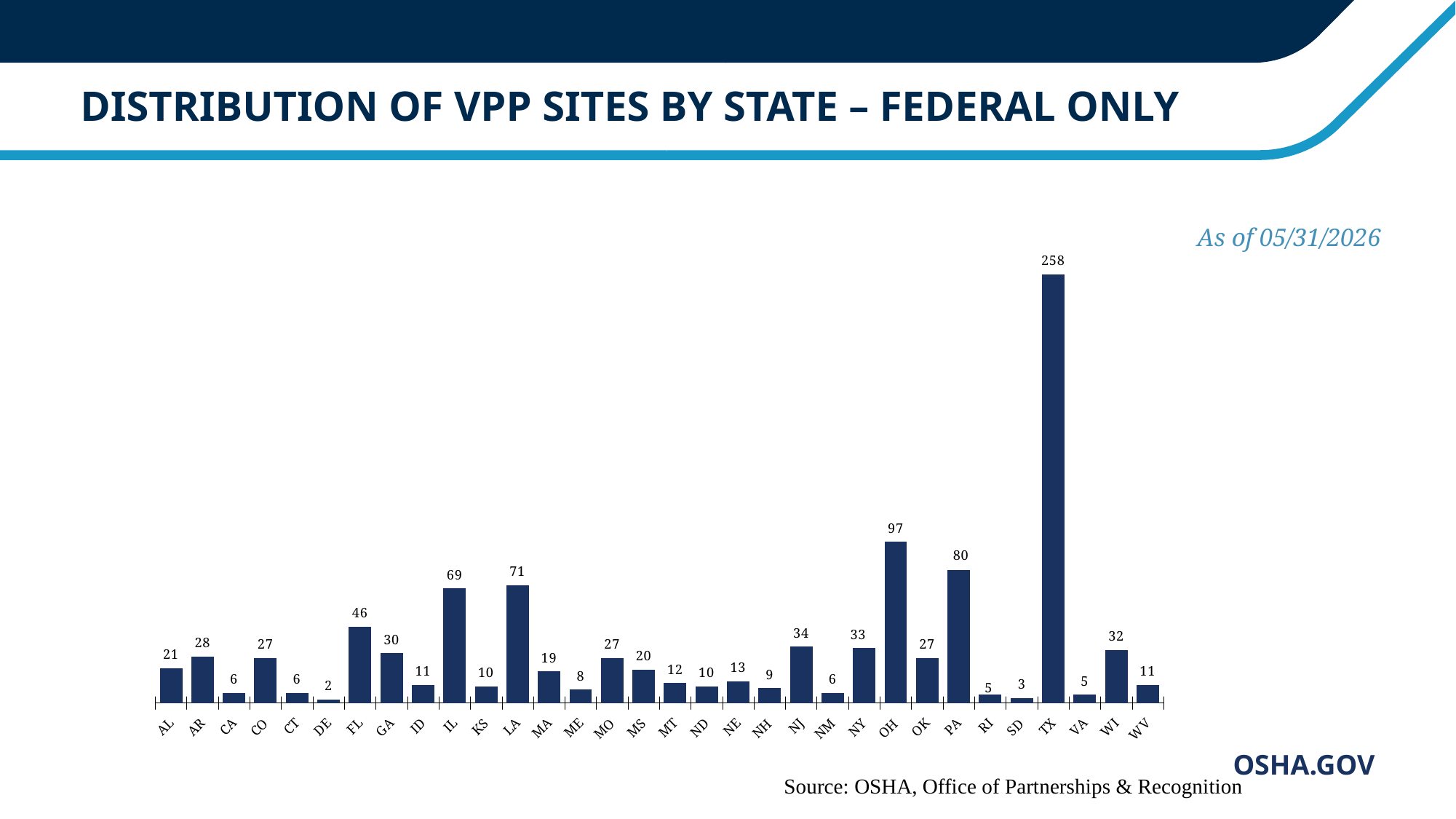
What is the value for FL? 46 What is the value for TX? 258 How many states are shown on the x axis? 32 Which is larger, the value for GA or the value for WI? WI What is the title of the slide? DISTRIBUTION OF VPP SITES BY STATE – FEDERAL ONLY Which state has the highest value? TX What is the value for OH? 97 What is the difference between the values for LA and IL? 2 Which is larger, the value for NJ or the value for NY? NJ What is the difference between the values for PA and OH? 17 Which state has the lowest value? DE What kind of chart is shown on the slide? Bar chart